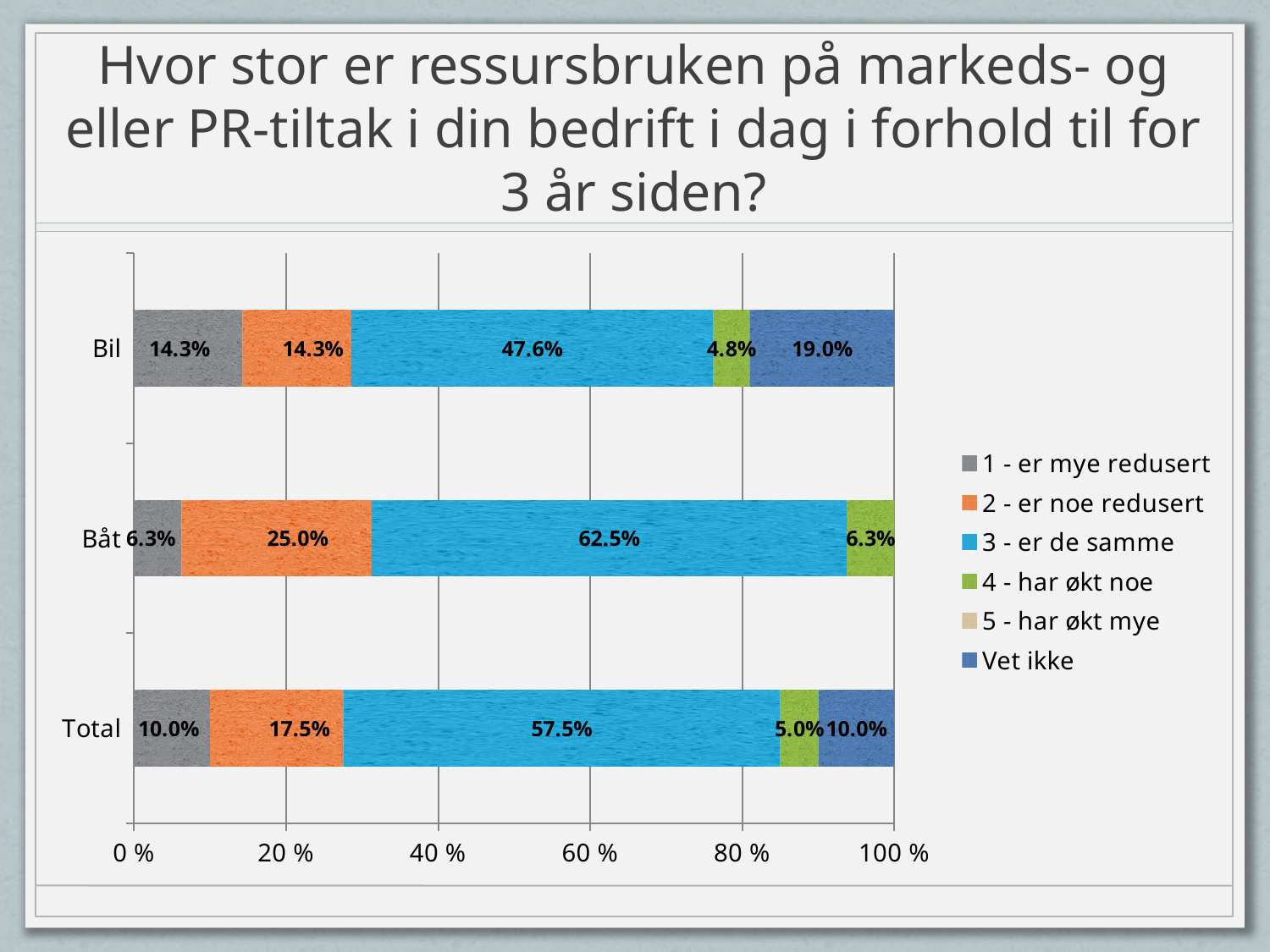
What is the value for 'Vet ikke' in the Total bar? 10.0% What is the value for '3 - er de samme' in the Bil bar? 47.6% Which category has the highest value for '3 - er de samme'? Båt Which is larger: the 'Vet ikke' value for Bil or for Total? Bil Which legend entry is represented by the orange segments? 2 - er noe redusert Is the '3 - er de samme' value for Total greater or less than 50%? greater How many series does the legend list? 6 How many categories are shown on the vertical axis of the chart? 3 What is the difference between the '3 - er de samme' values for Båt and Bil? 14.9% What is the value for '2 - er noe redusert' in the Båt bar? 25.0% What type of chart is shown on the slide? Stacked bar chart Which category has the lowest value for '1 - er mye redusert'? Båt